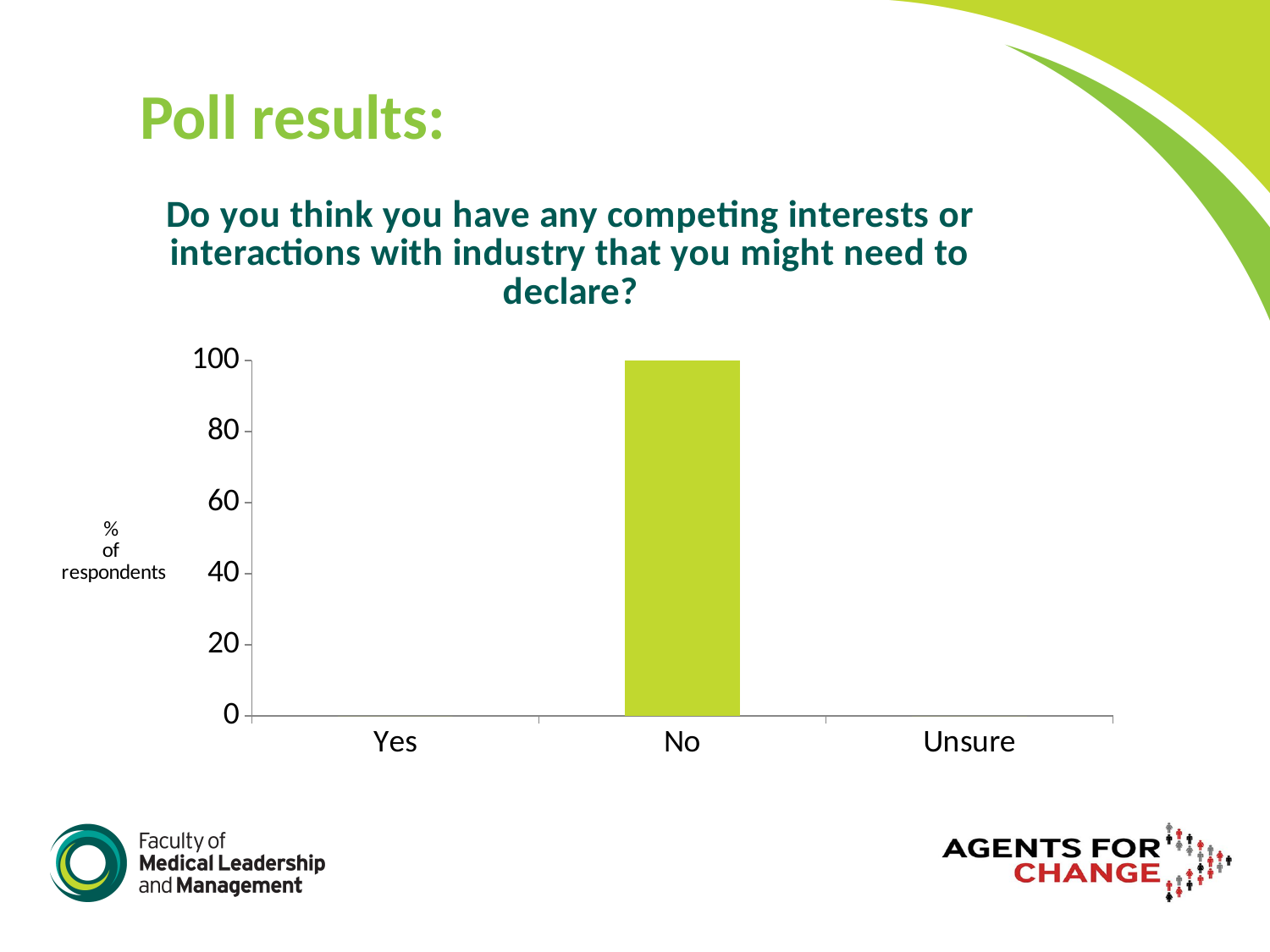
Which is larger, the value for "No" or the value for "Unsure"? No What is the value for "Yes" in the chart? 0 Which category has the highest value in the chart? No What is the label on the vertical axis of the chart? % of respondents What is the highest tick value shown on the vertical axis of the chart? 100 Is the value for "No" greater or less than 80? greater What is the value for "Unsure" in the chart? 0 What is the value for "No" in the chart? 100 What is the difference between the value for "No" and the value for "Yes"? 100 Is the value for "Yes" greater or less than 20? less How many categories are shown on the x axis of the chart? 3 What kind of chart is shown on the slide? bar chart